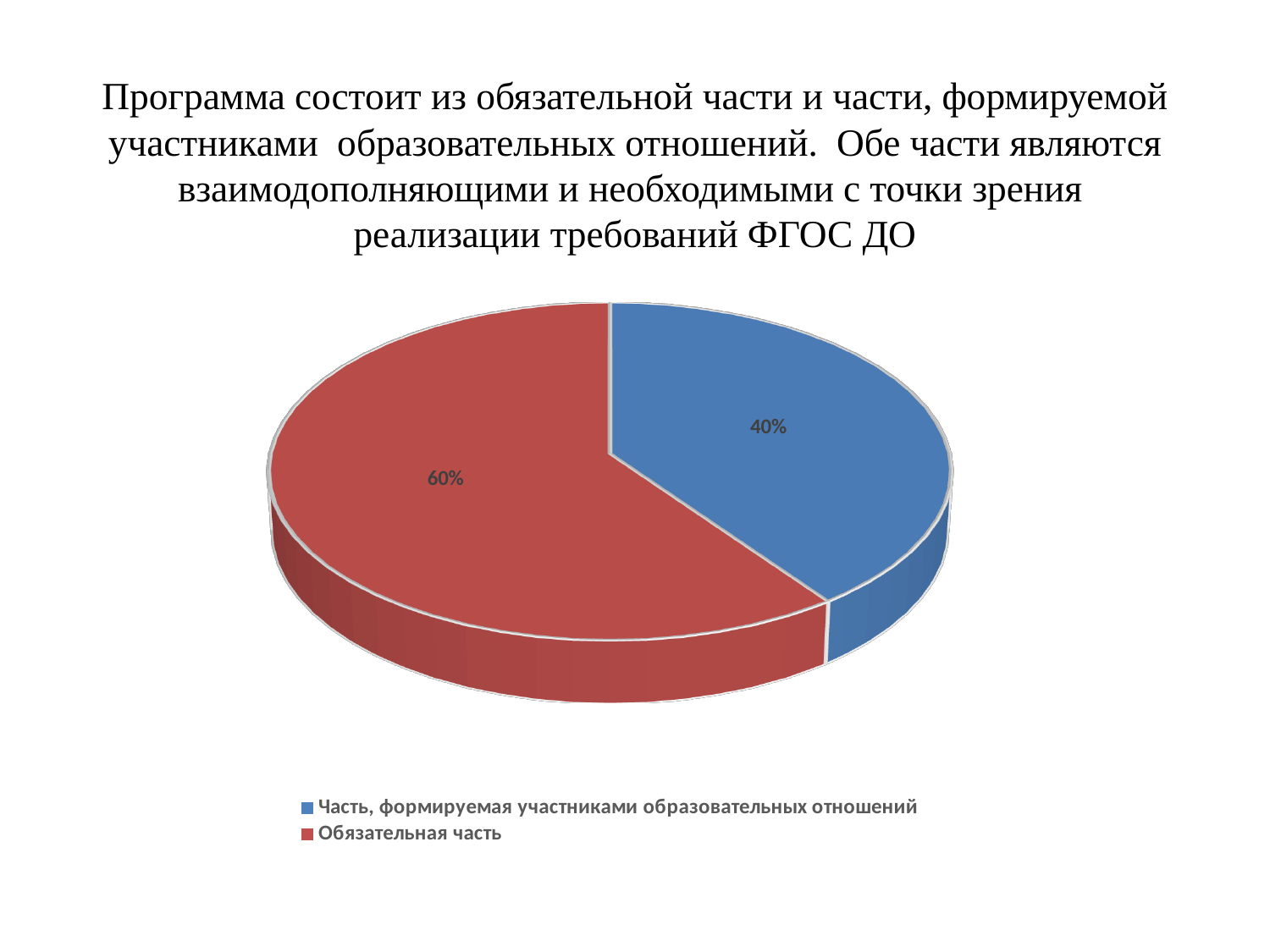
How many slices does the pie chart have? 2 What kind of chart is shown on the slide? Pie chart Which slice is the smallest? Часть, формируемая участниками образовательных отношений What share of the pie does "Часть, формируемая участниками образовательных отношений" take? 40% What share of the pie does "Обязательная часть" take? 60% What is the difference in percentage points between "Обязательная часть" and "Часть, формируемая участниками образовательных отношений"? 20% Which slice is the largest? Обязательная часть What colour is the slice for "Часть, формируемая участниками образовательных отношений"? Blue How many entries does the legend list? 2 Which is larger: "Обязательная часть" or "Часть, формируемая участниками образовательных отношений"? Обязательная часть What colour is the slice for "Обязательная часть"? Red